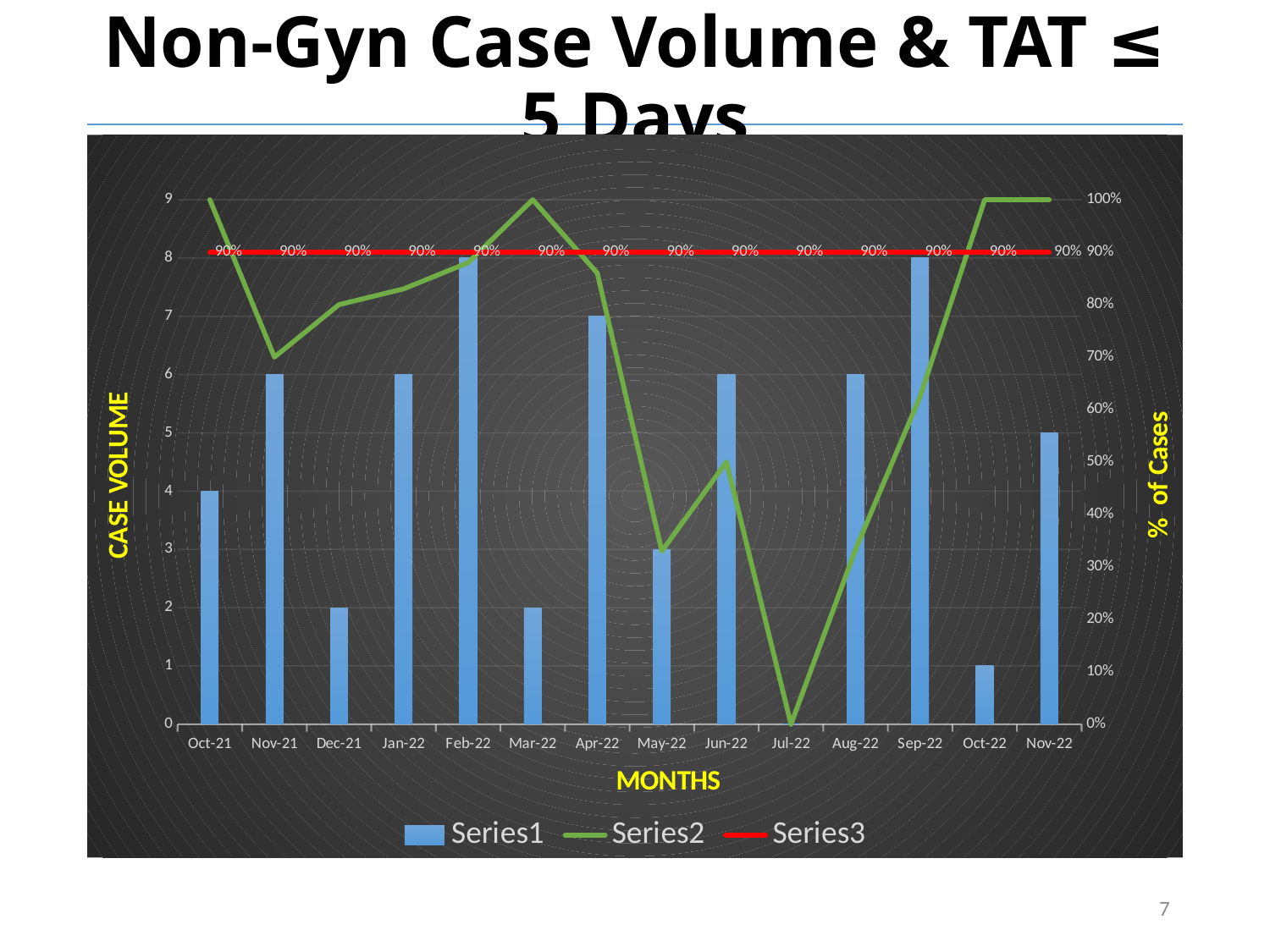
What is the Series1 case volume for Nov-22? 5 Is the Series2 value for May-22 greater or less than 40%? less Which month has the lowest Series1 case volume? Jul-22 How many months are shown on the x axis? 14 What kind of chart is shown on the slide? Combination bar and line chart How many series does the legend list? 3 Which month has a larger Series1 case volume, Nov-21 or Dec-21? Nov-21 What is the Series1 case volume for Oct-21? 4 What is the difference between the Series1 case volume for Feb-22 and Mar-22? 6 What is the Series1 case volume for Feb-22? 8 Is the Series2 value for Nov-21 greater or less than 80%? less What value does the red Series3 line show for every month? 90%